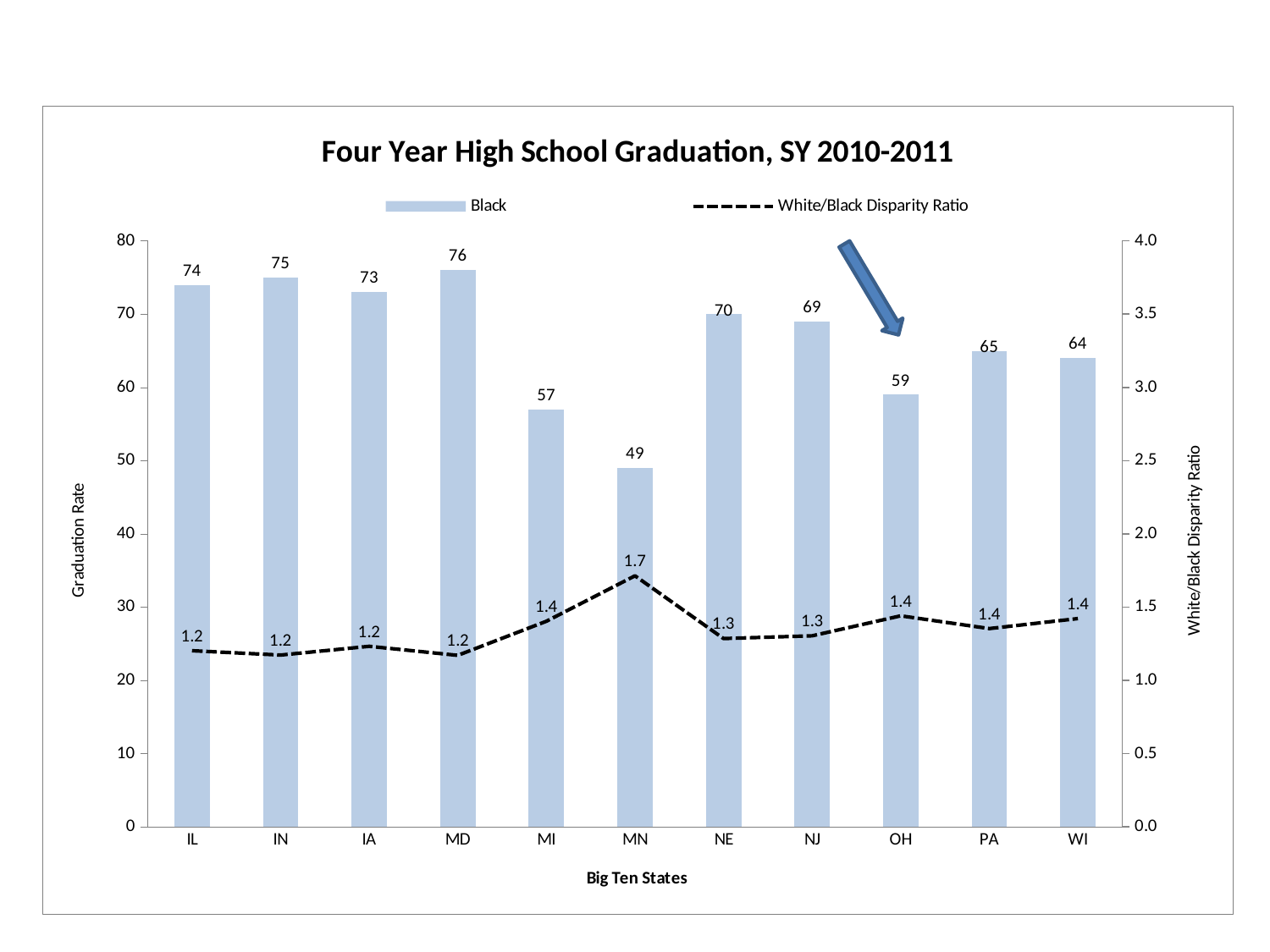
What is the Black graduation rate for OH? 59 What is the Black graduation rate for WI? 64 How many states are shown on the x axis? 11 What is the White/Black Disparity Ratio for MN? 1.7 Which state has the lowest Black graduation rate? MN What is the label of the x axis? Big Ten States What is the title of the chart? Four Year High School Graduation, SY 2010-2011 How many series does the legend list? 2 What is the difference between the Black graduation rates for MD and MN? 27 Which state has the highest Black graduation rate? MD Which state has a higher Black graduation rate, NE or PA? NE What kind of chart is this? Combined bar and line chart